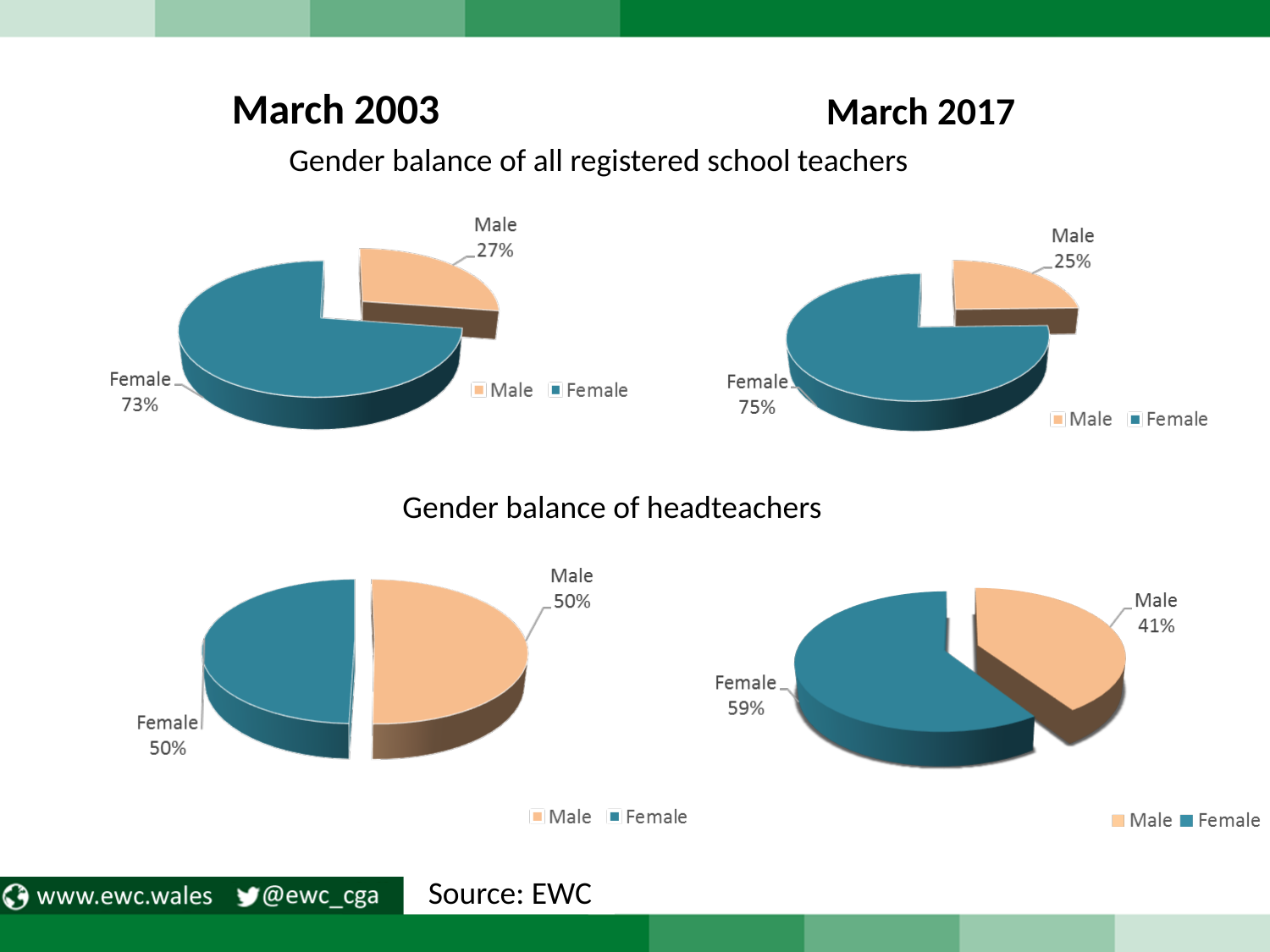
How many categories does the legend list in the March 2017 pie chart for all registered school teachers? 2 In the March 2017 pie chart for headteachers, what is the difference between the Female and Male shares? 18% What colour represents Female in the pie charts on the slide? Teal blue In the March 2017 pie chart for headteachers, which slice is larger, Male or Female? Female In the March 2003 pie chart for all registered school teachers, what percentage is Female? 73% In the March 2017 pie chart for all registered school teachers, which category has the smallest share? Male In the March 2017 pie chart for all registered school teachers, what percentage is Male? 25% What type of chart is used for the gender balance of headteachers in March 2003? Pie chart In the March 2003 pie chart for headteachers, what percentage is Male? 50% What is the difference between the Male share of all registered school teachers in March 2003 and in March 2017? 2% In the March 2003 pie chart for all registered school teachers, which category has the largest share? Female In the March 2017 pie chart for headteachers, what percentage is Female? 59%